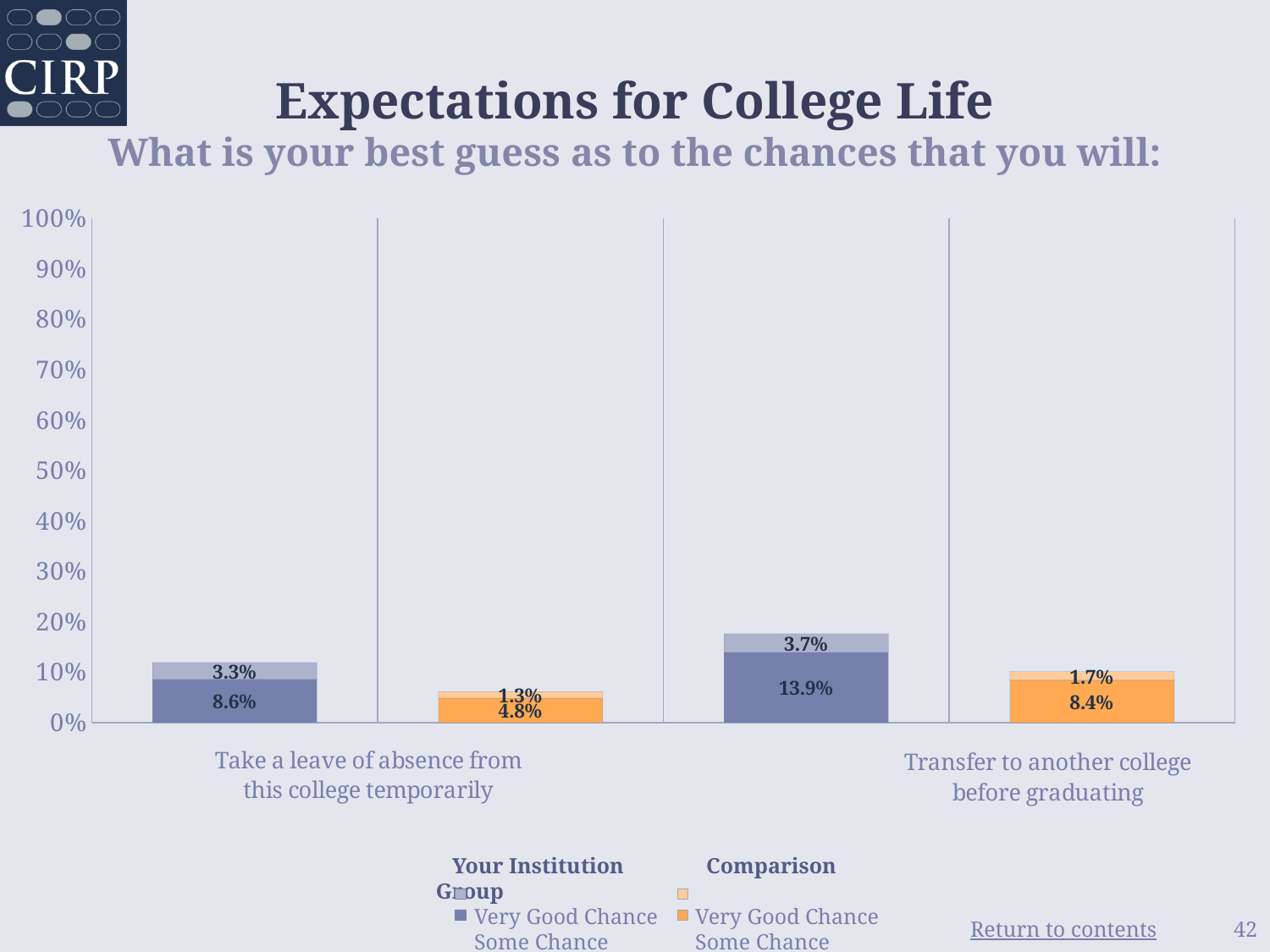
What is the total of the stacked bar for Your Institution for 'Transfer to another college before graduating'? 17.6% How many categories are shown on the x axis of the chart? 2 What is the difference between the 'Very Good Chance' values for Your Institution and the Comparison Group for 'Transfer to another college before graduating'? 2.0% Which stacked bar is the tallest on the chart? Your Institution, Transfer to another college before graduating What is the 'Very Good Chance' value for the Comparison Group for 'Transfer to another college before graduating'? 1.7% What is the total of the stacked bar for the Comparison Group for 'Take a leave of absence from this college temporarily'? 6.1% What is the 'Very Good Chance' value for Your Institution for 'Take a leave of absence from this college temporarily'? 3.3% Which 'Very Good Chance' value is larger for 'Take a leave of absence from this college temporarily': Your Institution or the Comparison Group? Your Institution Is the total stacked bar for Your Institution for 'Take a leave of absence from this college temporarily' greater or less than 10%? greater What is the 'Some Chance' value for Your Institution for 'Transfer to another college before graduating'? 13.9% What kind of chart is shown on the slide? Stacked bar chart What is the 'Some Chance' value for the Comparison Group for 'Take a leave of absence from this college temporarily'? 4.8%